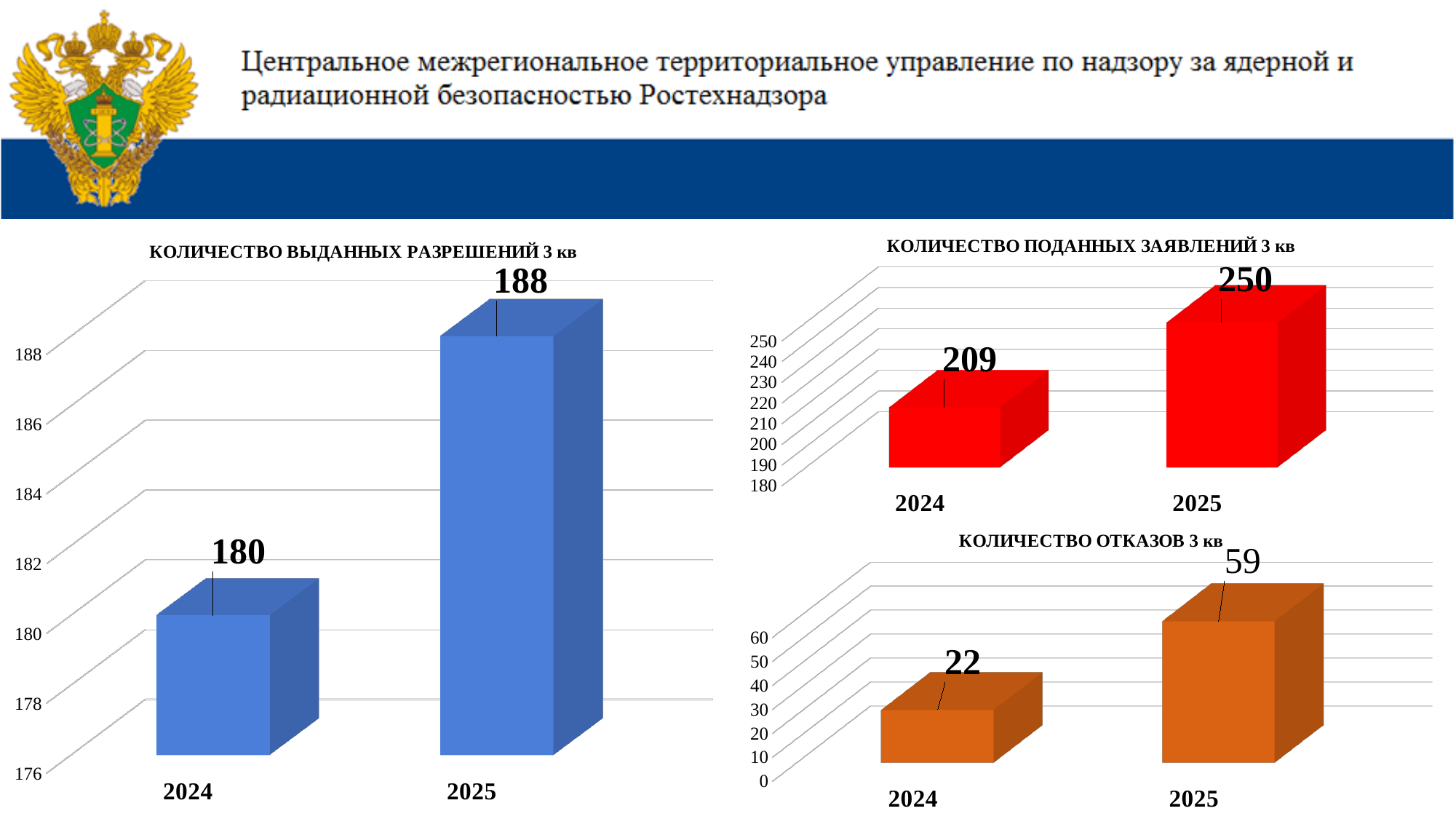
In the chart titled "КОЛИЧЕСТВО ПОДАННЫХ ЗАЯВЛЕНИЙ 3 кв", by how much does the 2025 value exceed the 2024 value? 41 In the chart titled "КОЛИЧЕСТВО ПОДАННЫХ ЗАЯВЛЕНИЙ 3 кв", which year has the highest value? 2025 In the chart titled "КОЛИЧЕСТВО ВЫДАННЫХ РАЗРЕШЕНИЙ 3 кв", what is the difference between the 2025 and 2024 values? 8 In the chart titled "КОЛИЧЕСТВО ПОДАННЫХ ЗАЯВЛЕНИЙ 3 кв", what is the value for 2025? 250 In the chart titled "КОЛИЧЕСТВО ВЫДАННЫХ РАЗРЕШЕНИЙ 3 кв", what is the value for 2025? 188 What kind of chart is the one titled "КОЛИЧЕСТВО ВЫДАННЫХ РАЗРЕШЕНИЙ 3 кв"? bar chart In the chart titled "КОЛИЧЕСТВО ОТКАЗОВ 3 кв", do the values rise or fall from 2024 to 2025? rise In the chart titled "КОЛИЧЕСТВО ВЫДАННЫХ РАЗРЕШЕНИЙ 3 кв", what is the value for 2024? 180 In the chart titled "КОЛИЧЕСТВО ОТКАЗОВ 3 кв", what is the value for 2025? 59 In the chart titled "КОЛИЧЕСТВО ПОДАННЫХ ЗАЯВЛЕНИЙ 3 кв", what is the value for 2024? 209 In the chart titled "КОЛИЧЕСТВО ОТКАЗОВ 3 кв", what is the value for 2024? 22 In the chart titled "КОЛИЧЕСТВО ОТКАЗОВ 3 кв", which year has the lowest value? 2024